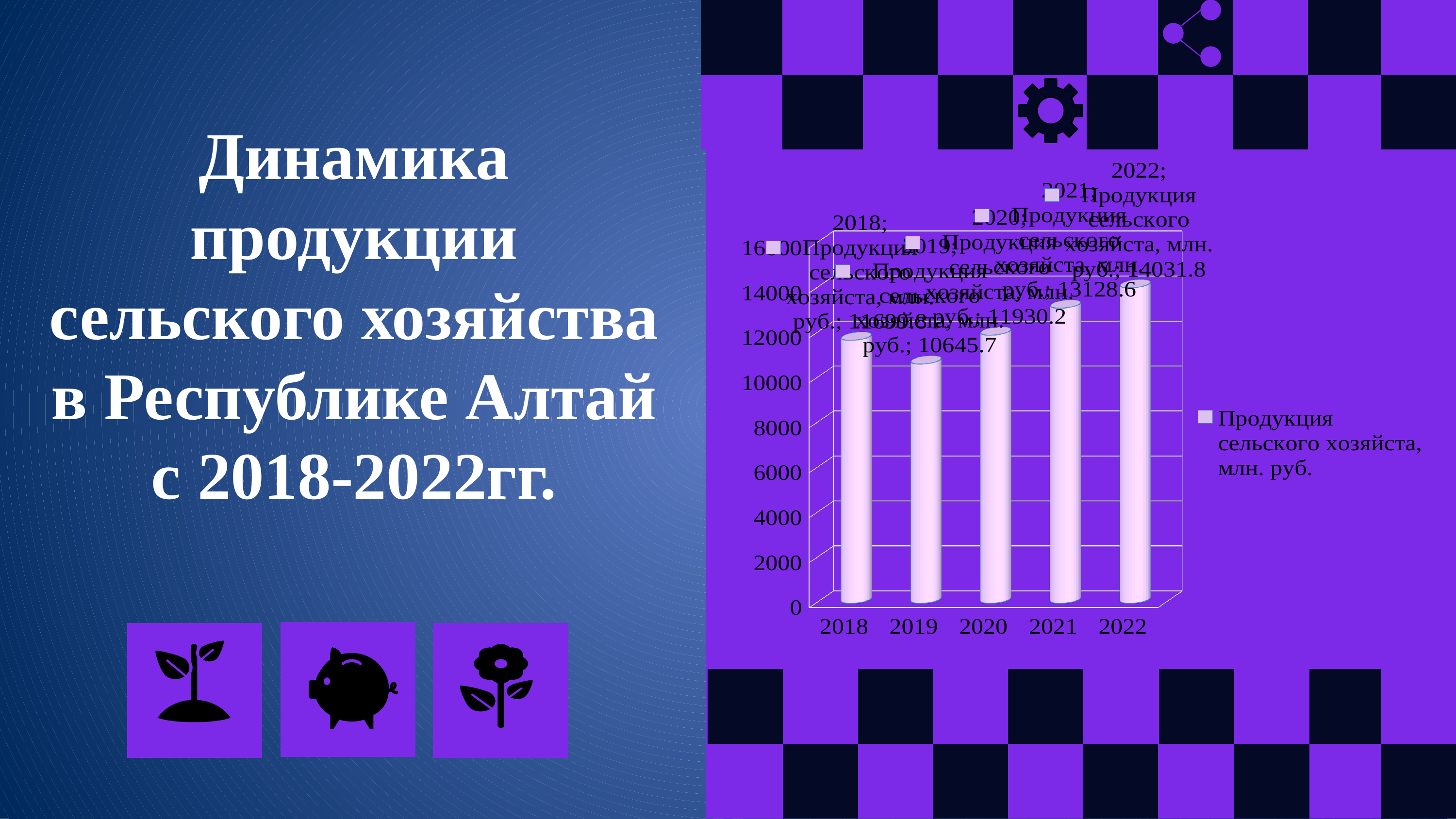
By how much did agricultural output increase from 2021 to 2022? 903.2 Is the value for 2018 greater or less than 10000? greater How many series does the chart legend list? 1 Which year has the highest agricultural output in the chart? 2022 What kind of chart is shown on the slide? bar chart How many years (categories) are plotted on the x axis of the chart? 5 What is the value of agricultural output for 2021? 13128.6 What is the value of agricultural output (Продукция сельского хозяйства, млн. руб.) for 2019? 10645.7 What is the value of agricultural output for 2022? 14031.8 What is the value of agricultural output for 2020? 11930.2 Which year has the larger agricultural output, 2019 or 2020? 2020 Which year has the lowest agricultural output in the chart? 2019